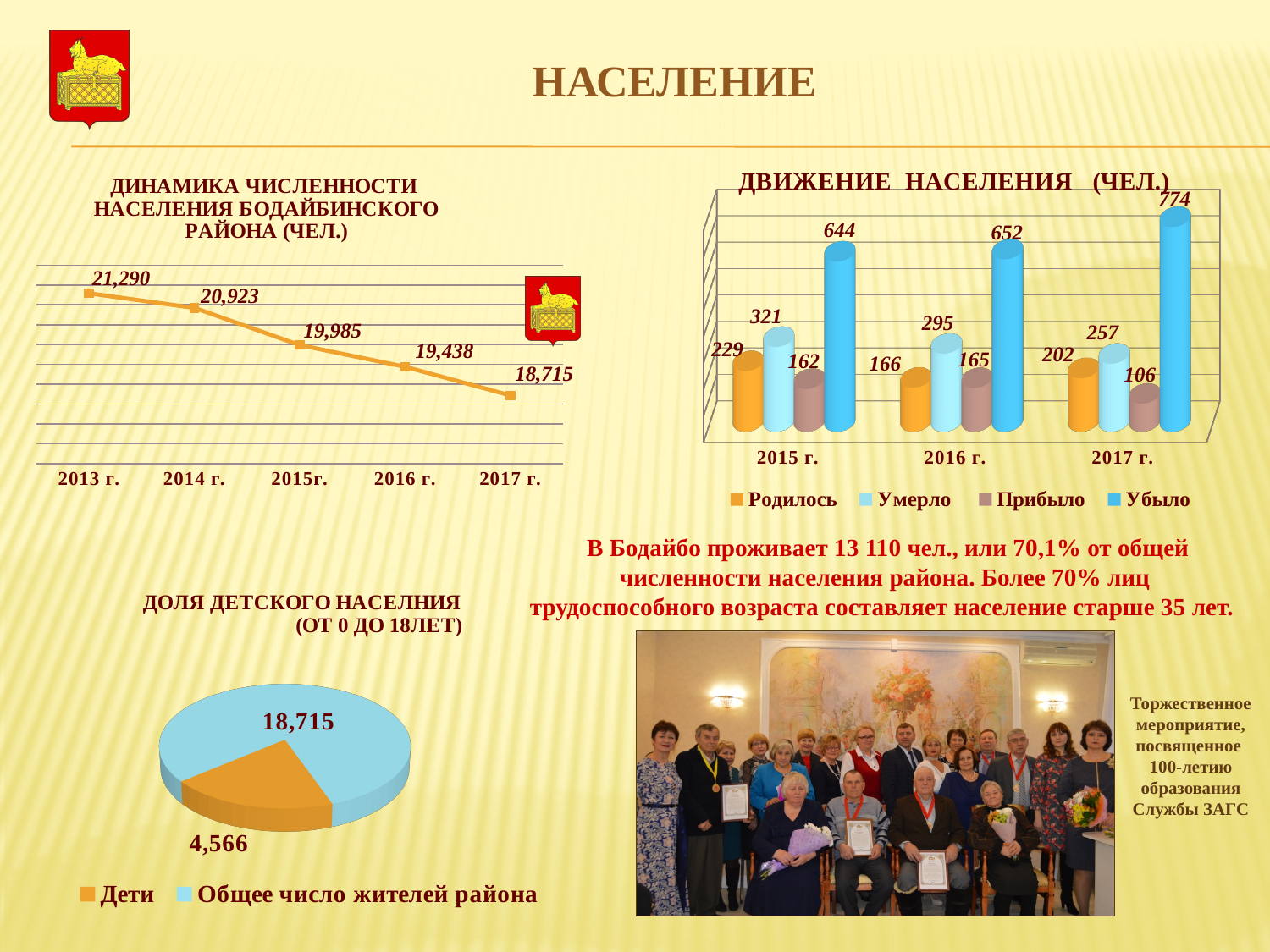
In the bar chart 'Движение населения (чел.)', which year has the lowest value for Прибыло? 2017 г. In the line chart 'Динамика численности населения Бодайбинского района (чел.)', what was the population in 2013? 21,290 In the line chart 'Динамика численности населения Бодайбинского района (чел.)', does the population rise or fall from 2013 to 2017? fall In the bar chart 'Движение населения (чел.)', what is the difference between Умерло and Родилось in 2015? 92 In the bar chart 'Движение населения (чел.)', what is the value for Родилось in 2016? 166 In the pie chart 'Доля детского населения (от 0 до 18 лет)', what is the value for Дети? 4,566 How many years are plotted in the line chart 'Динамика численности населения Бодайбинского района (чел.)'? 5 In the line chart 'Динамика численности населения Бодайбинского района (чел.)', what was the population in 2017? 18,715 In the bar chart 'Движение населения (чел.)', what is the value for Убыло in 2017? 774 In the line chart 'Динамика численности населения Бодайбинского района (чел.)', by how much did the population decrease from 2013 to 2017? 2,575 What type of chart is 'Доля детского населения (от 0 до 18 лет)'? pie chart How many series does the legend of the bar chart 'Движение населения (чел.)' list? 4